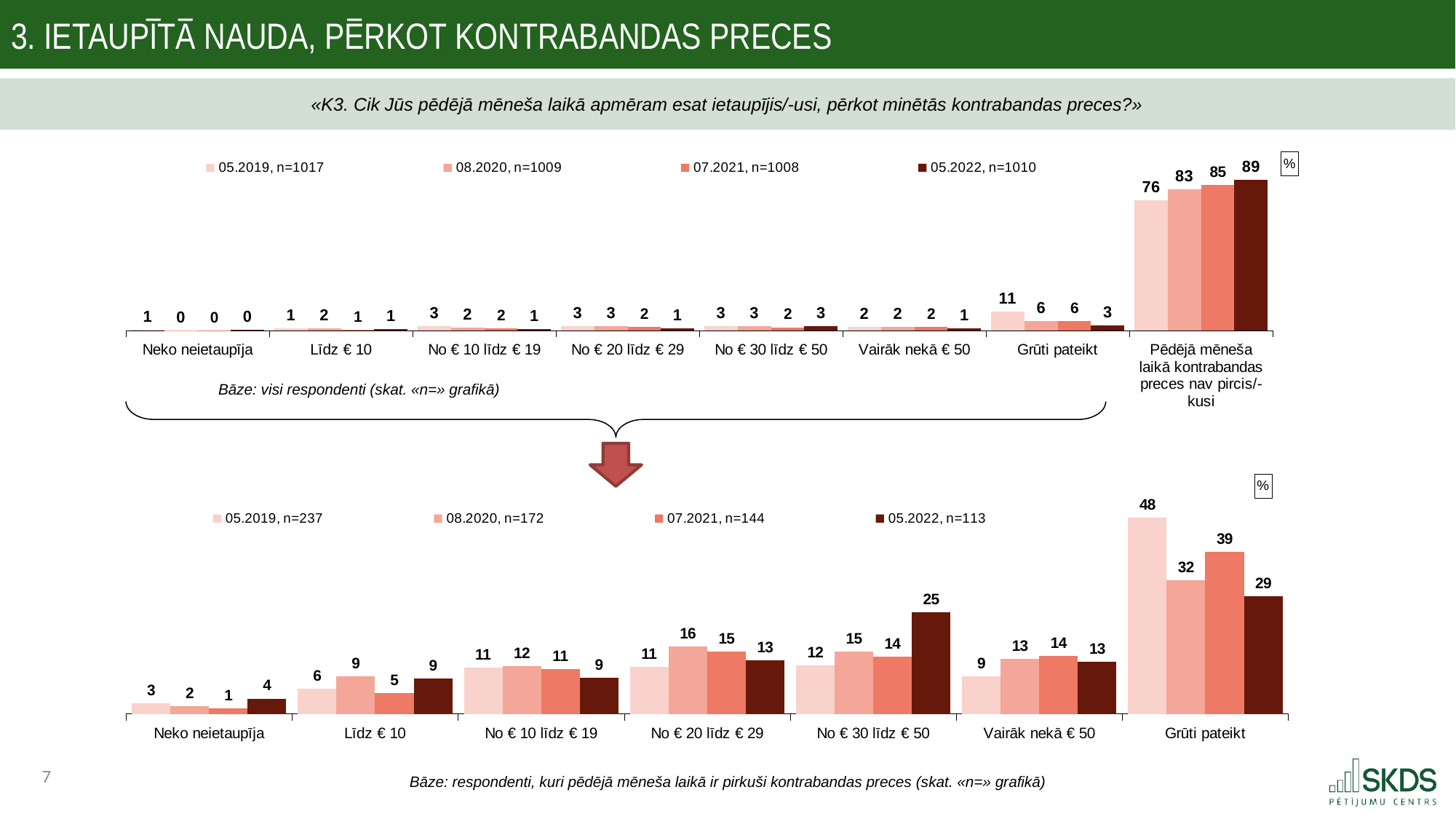
In the top chart, what is the difference between the 05.2022 and 05.2019 values for 'Pēdējā mēneša laikā kontrabandas preces nav pircis/-kusi'? 13 In the bottom chart, which category has the lowest value in the 07.2021 series? Neko neietaupīja In the top chart, how many series does the legend list? 4 In the top chart, do the values for 'Pēdējā mēneša laikā kontrabandas preces nav pircis/-kusi' rise or fall from 05.2019 to 05.2022? rise In the bottom chart, which is larger for 'No € 20 līdz € 29': the 08.2020 value or the 05.2022 value? 08.2020 What type of chart is the bottom chart? bar chart In the bottom chart, what is the difference between the 05.2019 and 05.2022 values for 'Grūti pateikt'? 19 In the bottom chart, which category has the highest value in the 05.2019 series? Grūti pateikt In the bottom chart, what is the value for 'No € 30 līdz € 50' in the 05.2022 series? 25 In the bottom chart, how many categories are shown on the x axis? 7 In the top chart, what is the value for 'Grūti pateikt' in the 05.2019 series? 11 In the top chart, what is the value for 'Pēdējā mēneša laikā kontrabandas preces nav pircis/-kusi' in the 05.2022 series? 89